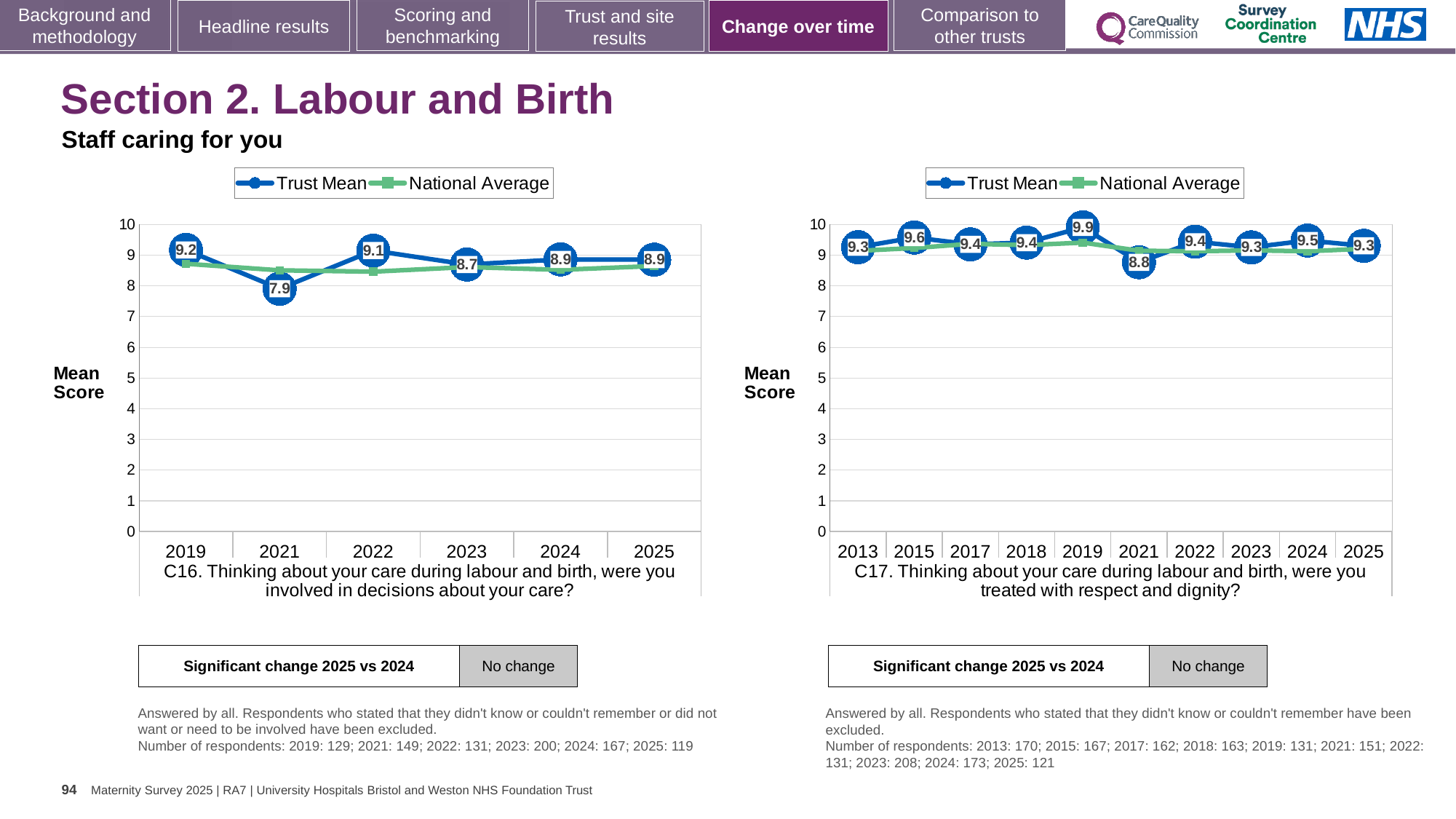
In the C17 chart on the right, is the Trust Mean for 2024 larger or smaller than the Trust Mean for 2021? larger In the C17 chart on the right, what is the Trust Mean for 2019? 9.9 What type of chart is the C17 chart on the right? Line chart In the C16 chart on the left, which year has the highest Trust Mean? 2019 In the C16 chart on the left, what is the Trust Mean for 2025? 8.9 In the C16 chart on the left, what is the difference between the Trust Mean for 2019 and 2021? 1.3 In the C16 chart on the left, is the National Average for 2021 greater or less than 9? less In the C17 chart on the right, which year has the lowest Trust Mean? 2021 How many years are plotted on the x axis of the C17 chart on the right? 10 In the C16 chart on the left, what is the Trust Mean for 2021? 7.9 How many series does the legend of the C16 chart on the left list? 2 In the C16 chart on the left, which year has the lowest Trust Mean? 2021